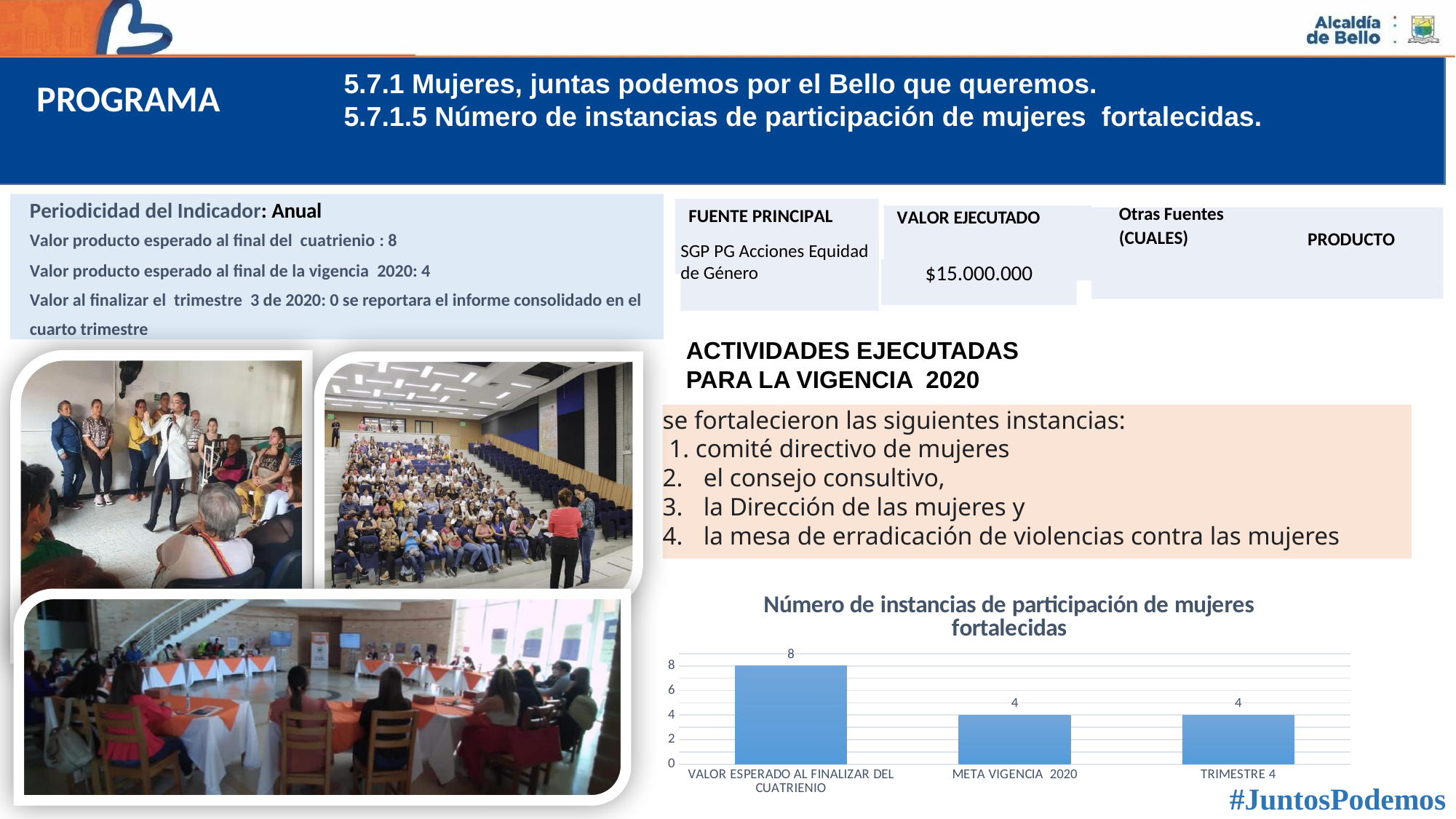
What is the value for TRIMESTRE 4? 4 What is the value for VALOR ESPERADO AL FINALIZAR DEL CUATRIENIO? 8 Is the value for VALOR ESPERADO AL FINALIZAR DEL CUATRIENIO greater or less than 6? greater What is the value for META VIGENCIA 2020? 4 Which is larger, the value for VALOR ESPERADO AL FINALIZAR DEL CUATRIENIO or the value for TRIMESTRE 4? VALOR ESPERADO AL FINALIZAR DEL CUATRIENIO Do the values rise or fall from the first category to the last? fall What kind of chart is shown on the slide? bar chart Is the value for META VIGENCIA 2020 greater or less than 6? less What is the title of the chart? Número de instancias de participación de mujeres fortalecidas What is the difference between the value for VALOR ESPERADO AL FINALIZAR DEL CUATRIENIO and the value for META VIGENCIA 2020? 4 Which category has the highest value? VALOR ESPERADO AL FINALIZAR DEL CUATRIENIO How many categories are shown in the chart? 3